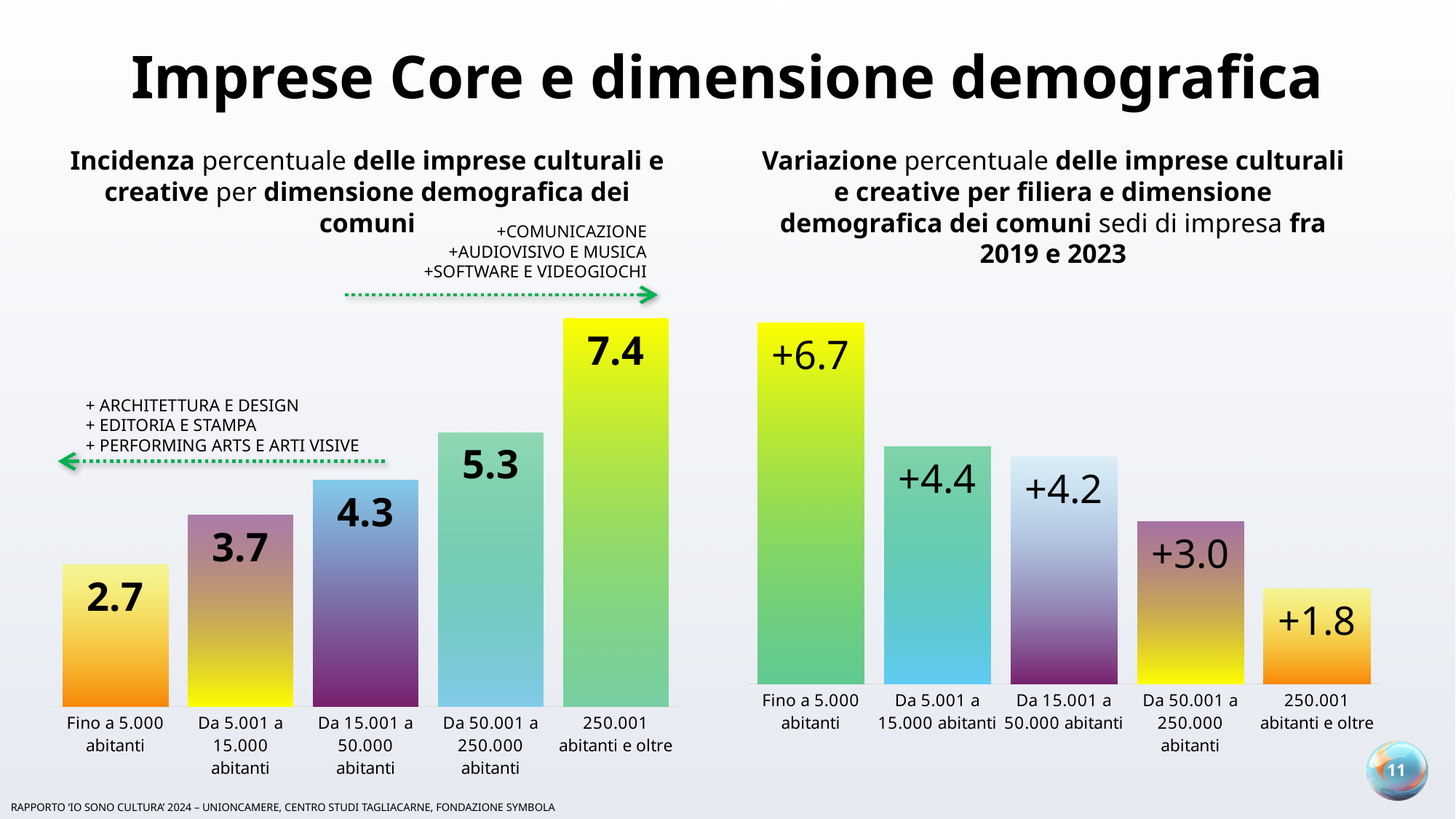
In the left chart (Incidenza percentuale), what is the difference between the values for '250.001 abitanti e oltre' and 'Da 50.001 a 250.000 abitanti'? 2.1 In the left chart (Incidenza percentuale), which category has the lowest value? Fino a 5.000 abitanti In the left chart (Incidenza percentuale), what is the value for 'Fino a 5.000 abitanti'? 2.7 What kind of chart is the left chart (Incidenza percentuale)? bar chart In the left chart (Incidenza percentuale), what is the value for '250.001 abitanti e oltre'? 7.4 In the right chart (Variazione percentuale), what is the difference between the values for 'Fino a 5.000 abitanti' and 'Da 50.001 a 250.000 abitanti'? 3.7 In the right chart (Variazione percentuale), do the values rise or fall from left to right along the x axis? fall In the left chart (Incidenza percentuale), how many categories are plotted? 5 In the right chart (Variazione percentuale), which category has the highest value? Fino a 5.000 abitanti In the right chart (Variazione percentuale), which category has the lowest value? 250.001 abitanti e oltre In the left chart (Incidenza percentuale), do the values rise or fall from left to right along the x axis? rise In the right chart (Variazione percentuale), what is the value for 'Da 15.001 a 50.000 abitanti'? +4.2